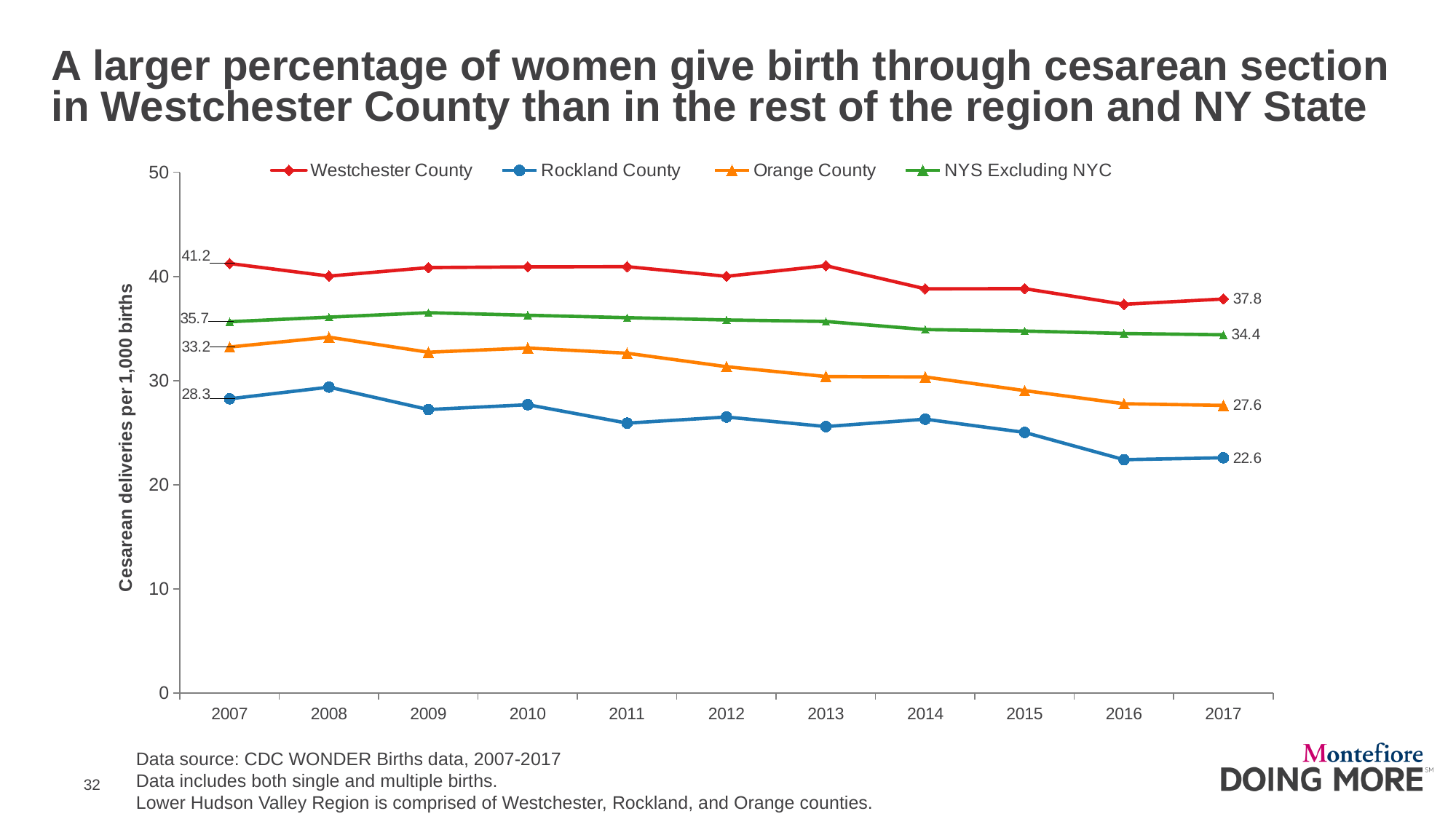
By how much did the Westchester County rate fall from 2007 (41.2) to 2017 (37.8)? 3.4 What was the cesarean delivery rate for Westchester County in 2007? 41.2 What was the cesarean delivery rate for NYS Excluding NYC in 2017? 34.4 What was the cesarean delivery rate for Orange County in 2007? 33.2 What type of chart is shown on the slide? Line chart Which series had the highest value in 2017? Westchester County Is the value for Rockland County in 2011 greater or less than 30? less How many series does the legend list? 4 Which series had the lowest value in 2007? Rockland County What was the cesarean delivery rate for Rockland County in 2017? 22.6 How many years are shown on the x axis? 11 Does the Orange County line generally rise or fall from 2007 to 2017? Fall